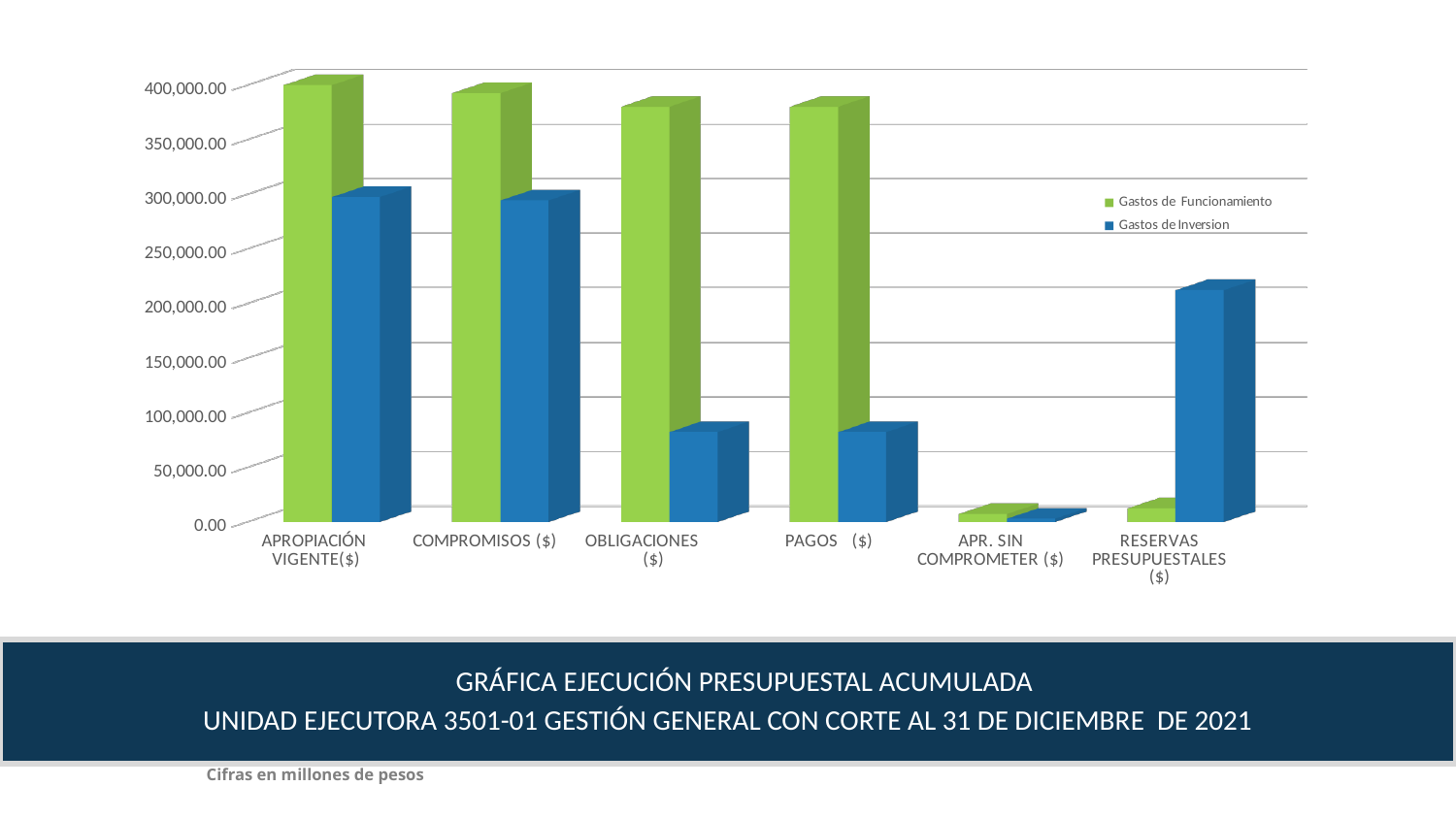
What kind of chart is shown on the slide? bar chart Is the Gastos de Inversion value for OBLIGACIONES ($) greater or less than 100,000.00? less Is the Gastos de Inversion value for RESERVAS PRESUPUESTALES ($) greater or less than 200,000.00? greater How many series does the legend list? 2 For APROPIACIÓN VIGENTE($), which series has the larger value, Gastos de Funcionamiento or Gastos de Inversion? Gastos de Funcionamiento Is the Gastos de Funcionamiento value for PAGOS ($) greater or less than 350,000.00? greater Which category has the highest value for Gastos de Funcionamiento? APROPIACIÓN VIGENTE($) For RESERVAS PRESUPUESTALES ($), which series has the larger value, Gastos de Funcionamiento or Gastos de Inversion? Gastos de Inversion Which category has the lowest value for Gastos de Inversion? APR. SIN COMPROMETER ($) Which category has the lowest value for Gastos de Funcionamiento? APR. SIN COMPROMETER ($) How many categories are shown on the x axis? 6 What colour represents Gastos de Inversion in the chart? blue